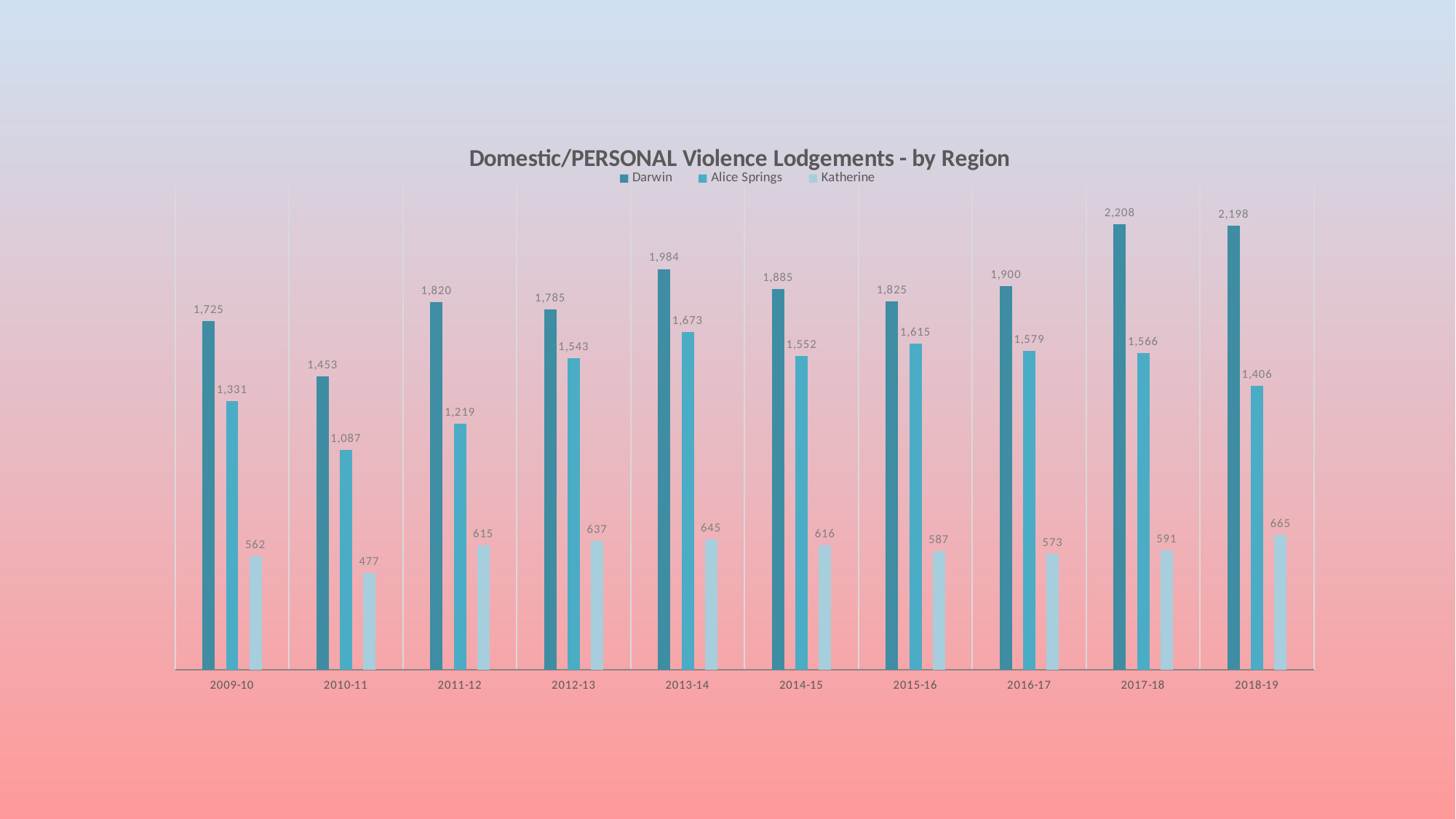
Which is larger: the Alice Springs value in 2015-16 or in 2016-17? 2015-16 Which series is shown in the lightest blue colour? Katherine What is the value for Katherine in 2018-19? 665 What is the title of the chart? Domestic/PERSONAL Violence Lodgements - by Region What is the difference between the Darwin and Alice Springs values in 2018-19? 792 In which year is the Katherine value lowest? 2010-11 What is the value for Darwin in 2013-14? 1,984 What is the value for Alice Springs in 2010-11? 1,087 In which year is the Darwin value highest? 2017-18 What kind of chart is shown on the slide? Bar chart How many series does the legend list? 3 How many years are shown on the x axis? 10